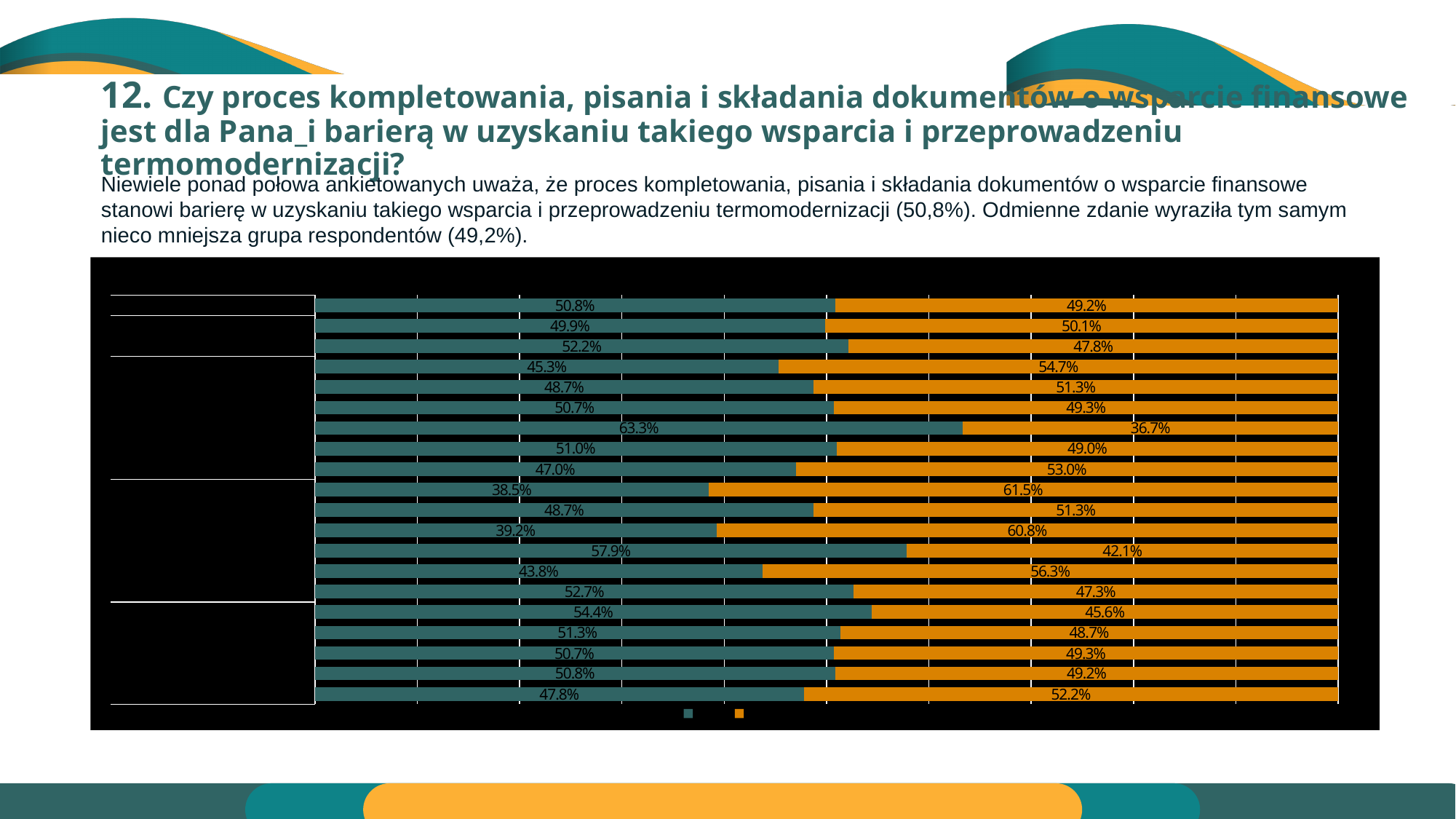
How many series does the legend list? 2 What is the orange (right) value of the bottommost bar? 52.2% What kind of chart is shown on the slide? bar chart What is the lowest value shown in the teal series? 38.5% What is the teal (left) value of the topmost bar? 50.8% What is the lowest value shown in the orange series? 36.7% What is the teal (left) value of the bottommost bar? 47.8% What is the difference between the teal and orange values in the topmost bar? 1.6 percentage points In the topmost bar, which segment is larger, the teal one or the orange one? the teal one (50.8%) What is the orange (right) value of the topmost bar? 49.2% How many bars (rows) does the chart contain? 20 What is the highest value shown in the teal series? 63.3%